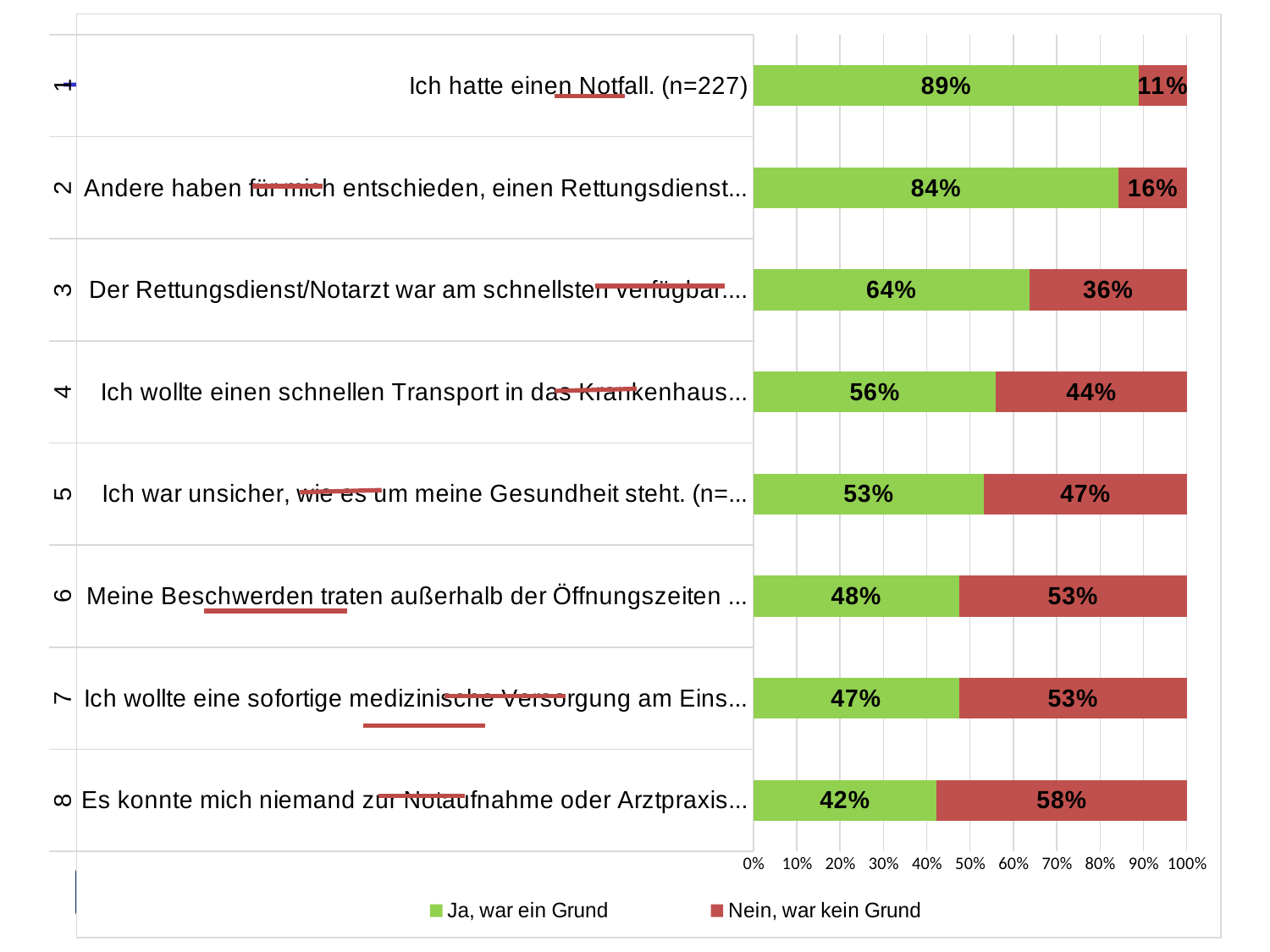
Which category has the lowest "Ja, war ein Grund" value? Es konnte mich niemand zur Notaufnahme oder Arztpraxis... What is the value of "Ja, war ein Grund" for "Ich hatte einen Notfall. (n=227)"? 89% What kind of chart is shown on the slide? stacked bar chart Which is larger for category 5, "Ich war unsicher, wie es um meine Gesundheit steht...": the "Ja, war ein Grund" value or the "Nein, war kein Grund" value? Ja, war ein Grund How many series does the legend list? 2 Which category has the highest "Ja, war ein Grund" value? Ich hatte einen Notfall. (n=227) What is the "Nein, war kein Grund" value for category 8, "Es konnte mich niemand zur Notaufnahme oder Arztpraxis..."? 58% What is the value of "Nein, war kein Grund" for "Ich hatte einen Notfall. (n=227)"? 11% How many categories (reasons) are plotted in the chart? 8 What is the "Ja, war ein Grund" value for category 3, "Der Rettungsdienst/Notarzt war am schnellsten verfügbar..."? 64% What is the difference between the "Ja, war ein Grund" values of category 2 ("Andere haben für mich entschieden...") and category 4 ("Ich wollte einen schnellen Transport...")? 28% Which colour represents the series "Nein, war kein Grund"? red